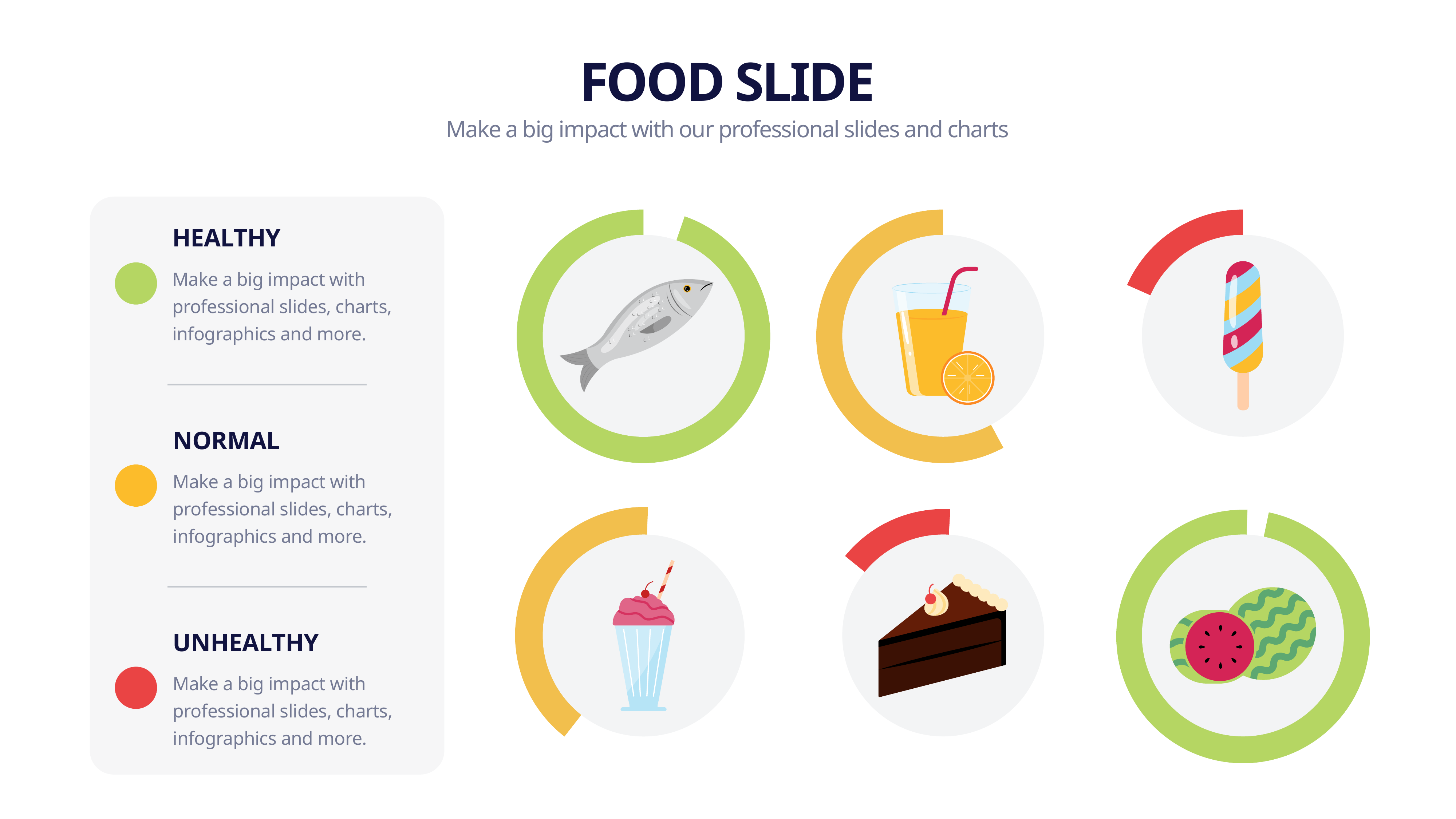
Which legend category is shown in red? Unhealthy How many of the six rings are coloured red? 2 How many categories does the legend on the left list? 3 Which ring is more filled: the fish ring or the popsicle ring? The fish ring Which legend category does the colour of the milkshake ring correspond to? Normal Which legend category is shown in green? Healthy Which ring is more filled: the orange juice ring or the cake ring? The orange juice ring How many ring charts are shown on the slide? 6 Which ring is more filled: the watermelon ring or the milkshake ring? The watermelon ring Which legend category does the colour of the popsicle ring correspond to? Unhealthy What kind of chart is used for each food item on the slide? Ring (donut) chart Which legend category does the colour of the watermelon ring correspond to? Healthy